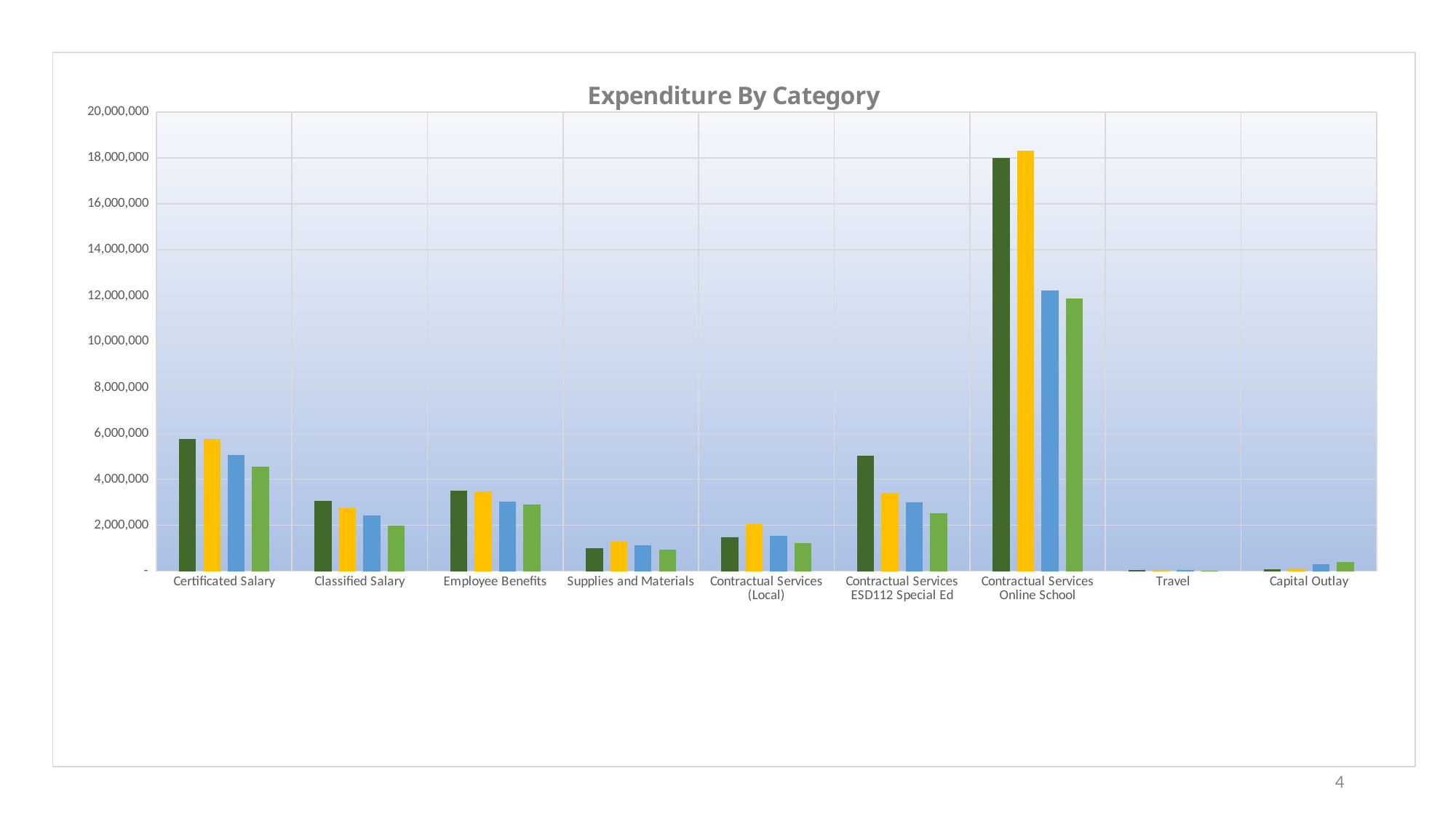
Is the dark green bar for Supplies and Materials greater or less than 2,000,000? less Which category has the highest expenditure in the chart? Contractual Services Online School Which has the larger dark green bar, Certificated Salary or Classified Salary? Certificated Salary What kind of chart is shown on the slide? bar chart Is the dark green bar for Certificated Salary greater or less than 4,000,000? greater How many bars are plotted for each category in the chart? 4 Which category has the lowest expenditure in the chart? Travel What is the title of the chart? Expenditure By Category Is the light green bar for Contractual Services Online School greater or less than 14,000,000? less How many categories are shown on the x axis of the chart? 9